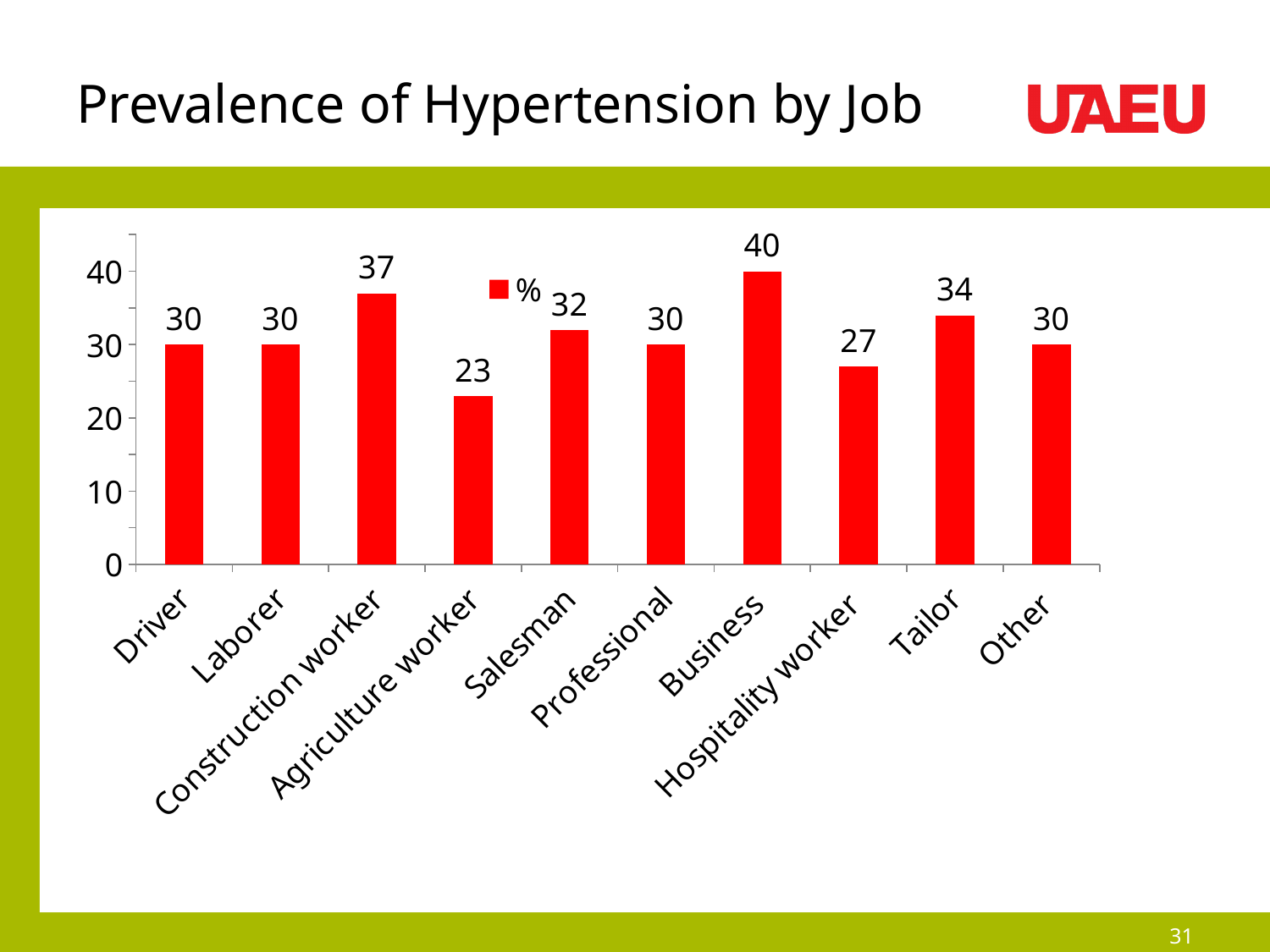
Which is larger, the value for Tailor or the value for Hospitality worker? Tailor What is the title of the slide? Prevalence of Hypertension by Job Which job category has the highest value? Business What is the value for Construction worker? 37 How many job categories are shown on the x axis? 10 Which job category has the lowest value? Agriculture worker What is the value for Hospitality worker? 27 What is the value for Tailor? 34 What is the difference between the values for Construction worker and Salesman? 5 What is the difference between the values for Business and Agriculture worker? 17 What kind of chart is shown on the slide? Bar chart How many series does the legend list? 1